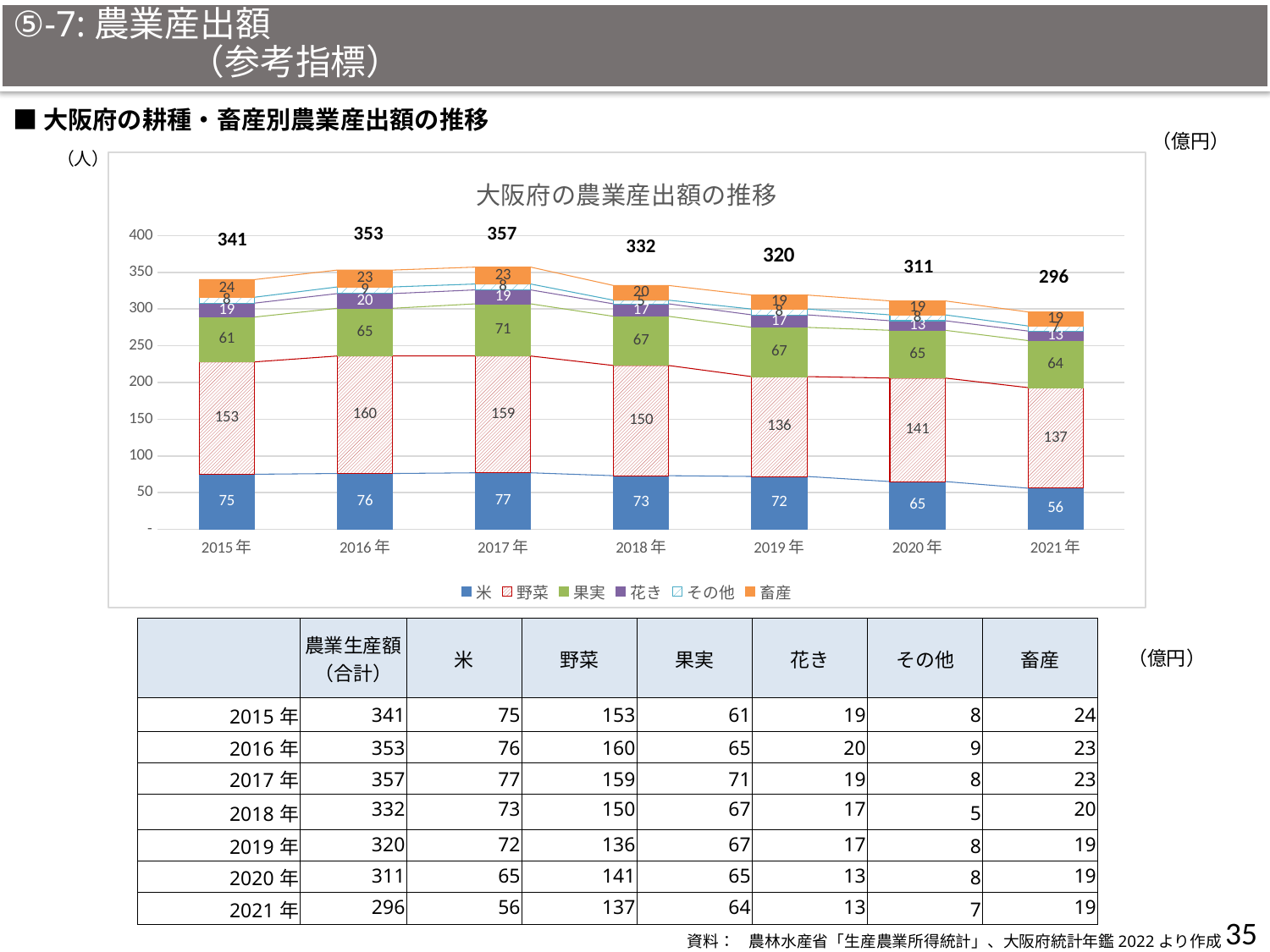
What is the difference between the 果実 value in 2017年 and in 2015年? 10 What is the value for 野菜 in 2016年? 160 Which year has the lowest total agricultural output in the chart? 2021年 How many years are shown on the x axis of the chart? 7 What is the total of the stacked bar for 2017年? 357 How many series does the chart legend list? 6 From 2017年 to 2021年, do the total values rise or fall? Fall What is the title of the chart? 大阪府の農業産出額の推移 Which year has the highest total agricultural output in the chart? 2017年 What is the value for 米 in 2021年? 56 What type of chart is shown on the slide? Stacked bar chart Which is larger, the 畜産 value in 2015年 or in 2021年? 2015年